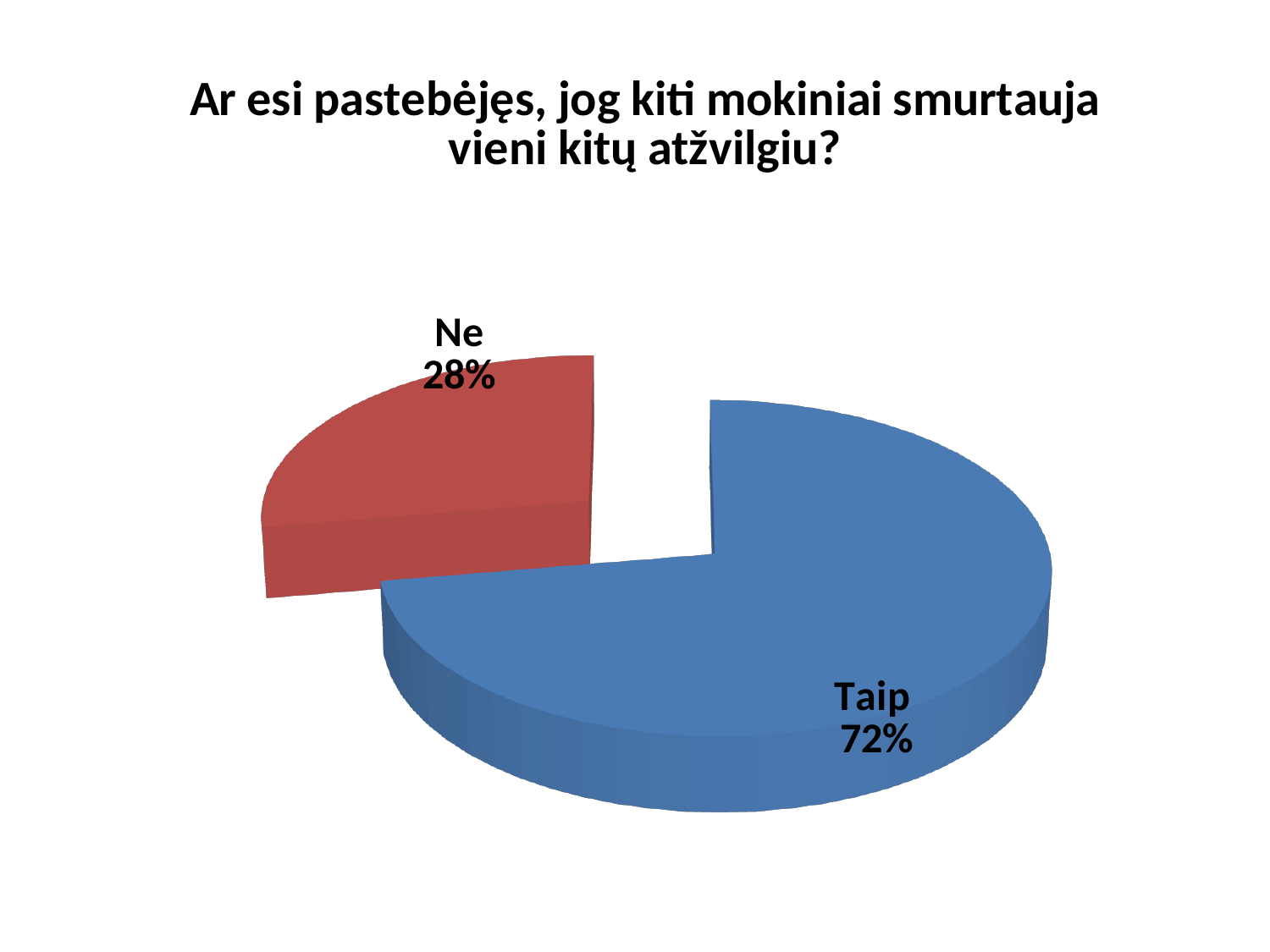
Which slice is larger, "Taip" or "Ne"? Taip What is the difference in percentage points between the "Taip" and "Ne" slices? 44 What colour is the "Taip" slice? Blue Which answer has the largest share of the pie? Taip How many slices does the pie chart have? 2 Which answer has the smallest share of the pie? Ne What is the title of the chart? Ar esi pastebėjęs, jog kiti mokiniai smurtauja vieni kitų atžvilgiu? What percentage of respondents answered "Ne"? 28% What share of the pie does the "Ne" slice represent? 28% What kind of chart is shown on the slide? Pie chart What percentage of respondents answered "Taip"? 72%